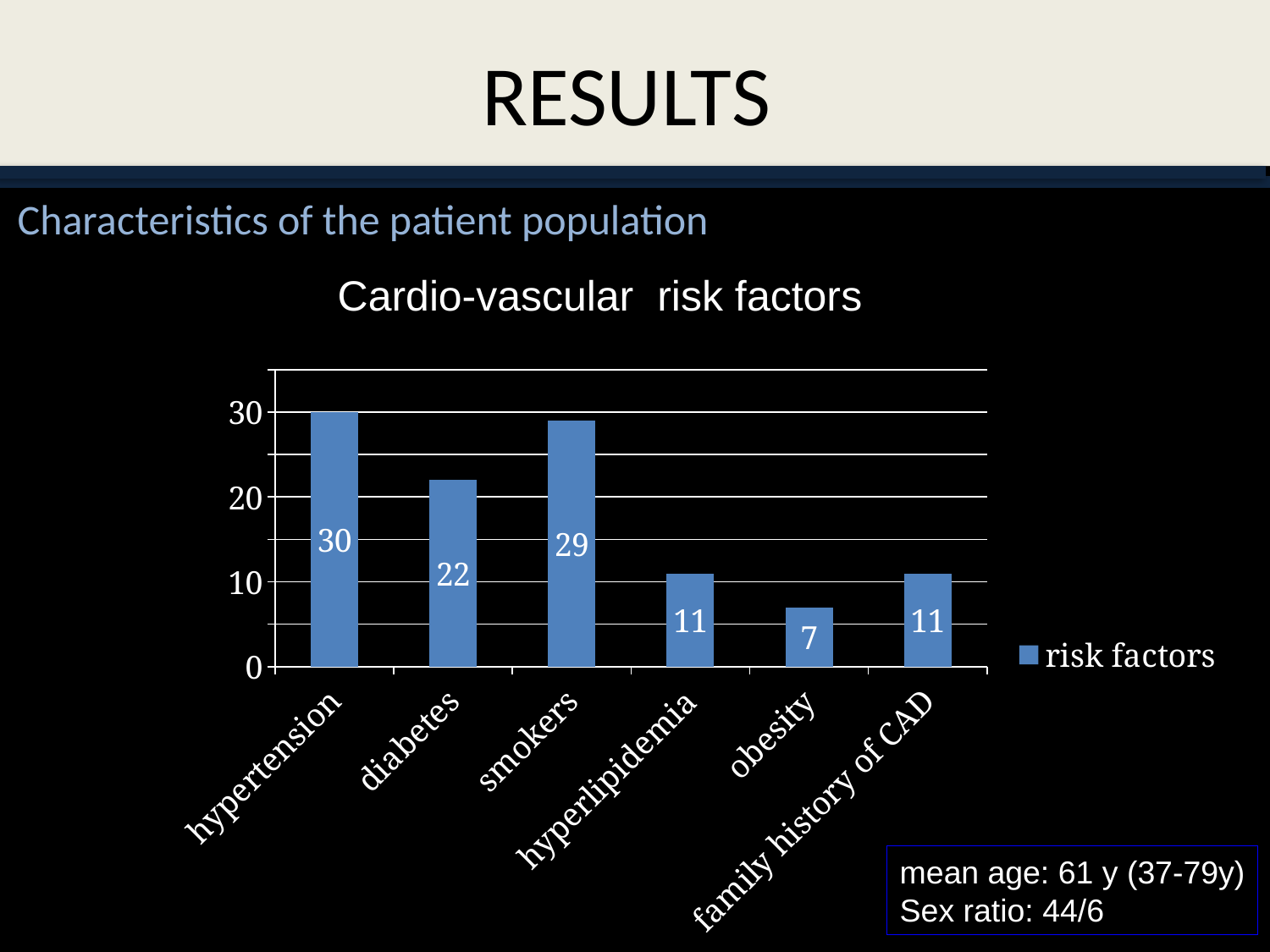
What is the difference between the values for hypertension and diabetes? 8 What is the value for obesity? 7 Is the value for smokers greater or less than 20? greater What kind of chart is shown? bar chart How many risk factor categories are shown on the x axis? 6 What is the difference between the values for smokers and obesity? 22 What is the value for diabetes? 22 Which risk factor has the highest value? hypertension How many series does the legend list? 1 Which is larger, the value for diabetes or the value for hyperlipidemia? diabetes What is the value for hypertension? 30 Which risk factor has the lowest value? obesity